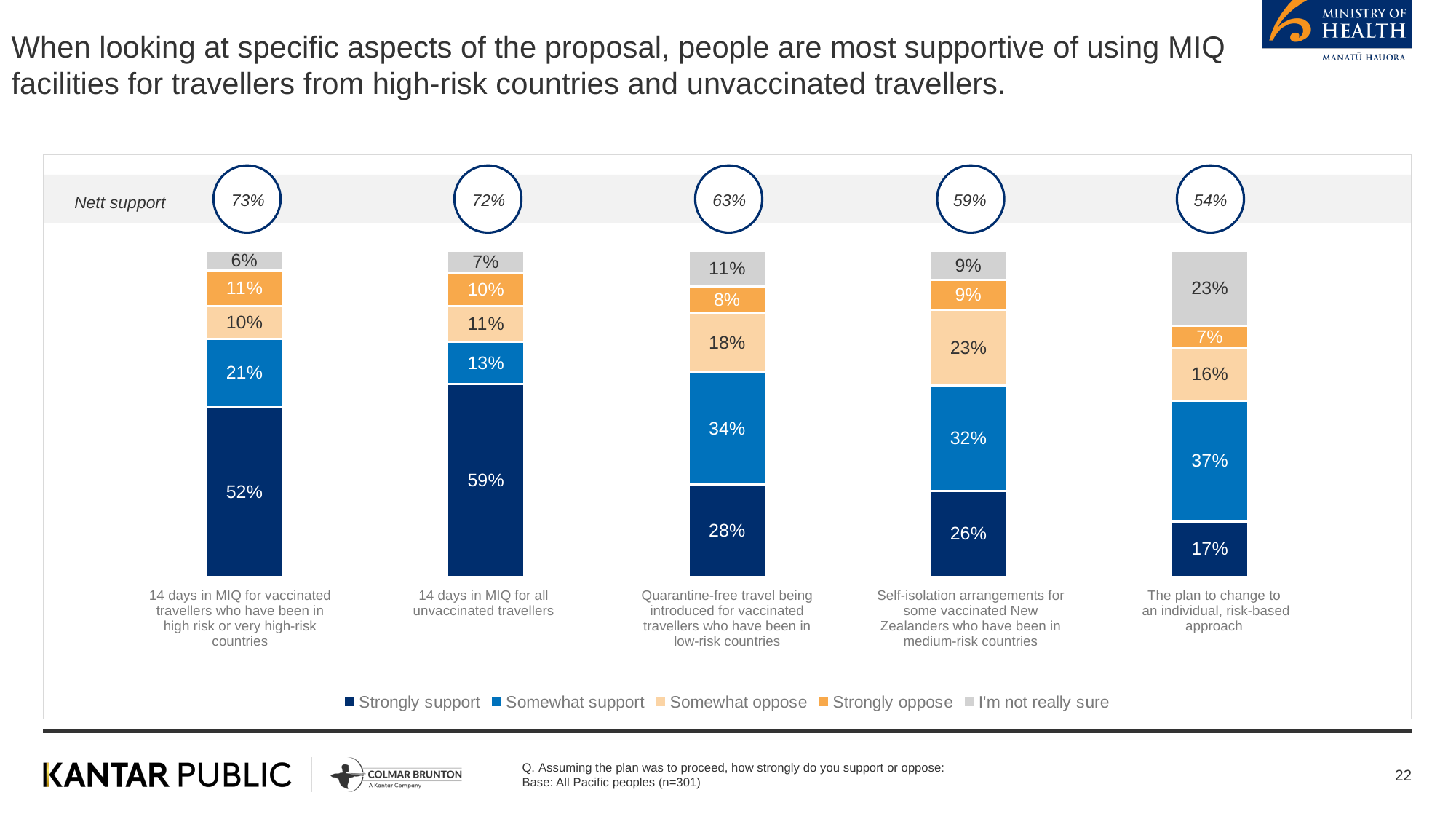
Which proposal aspect has the lowest nett support? The plan to change to an individual, risk-based approach What is the nett support for quarantine-free travel being introduced for vaccinated travellers who have been in low-risk countries? 63% How many proposal aspects (bars) are shown in the chart? 5 What percentage of respondents strongly support 14 days in MIQ for all unvaccinated travellers? 59% What is the difference between the 'Strongly support' values for 14 days in MIQ for vaccinated travellers from high-risk countries and for self-isolation arrangements for vaccinated New Zealanders from medium-risk countries? 26% Which proposal aspect has the highest 'Strongly support' value? 14 days in MIQ for all unvaccinated travellers Which legend entry is shown in the darkest blue colour? Strongly support What is the 'I'm not really sure' value for the plan to change to an individual, risk-based approach? 23% What is the combined 'Somewhat oppose' and 'Strongly oppose' value for self-isolation arrangements for vaccinated New Zealanders from medium-risk countries? 32% How many series does the legend list? 5 Which is larger: the 'Somewhat support' value for quarantine-free travel from low-risk countries or for the individual, risk-based approach? The plan to change to an individual, risk-based approach What kind of chart is shown on the slide? Stacked bar chart